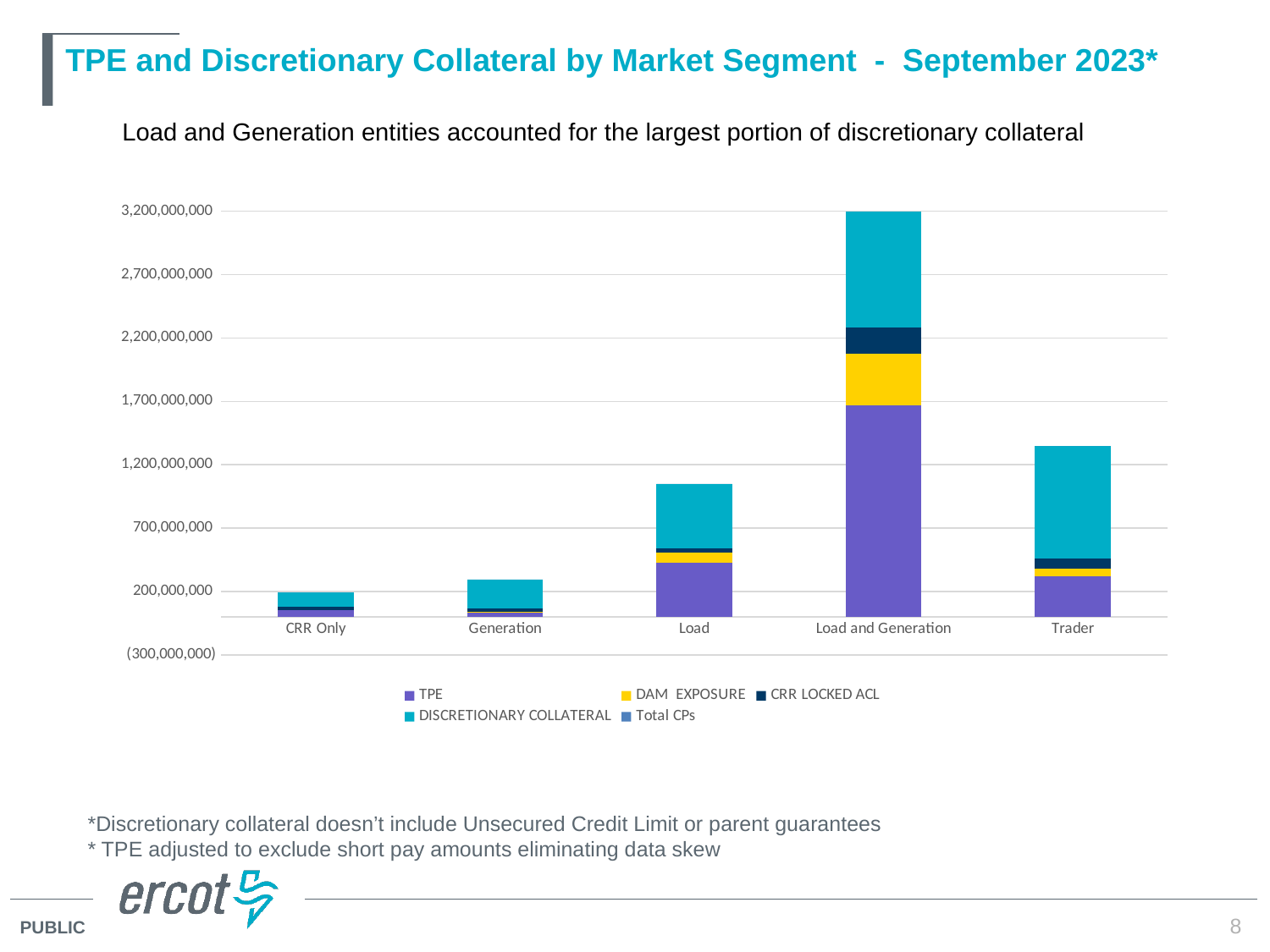
Which market segment has the shortest stacked bar? CRR Only Is the total height of the Generation bar greater or less than 200,000,000? greater Is the total height of the Trader bar greater or less than 1,200,000,000? greater Which series is shown in yellow in the legend? DAM EXPOSURE How many market segment categories are shown on the x axis? 5 Is the TPE segment for Load and Generation greater or less than 1,200,000,000? greater What kind of chart is shown on the slide? Stacked bar chart How many series does the legend list? 5 Which stacked bar is taller, Trader or Load? Trader What is the title of the slide containing the chart? TPE and Discretionary Collateral by Market Segment - September 2023* Which market segment has the tallest stacked bar? Load and Generation